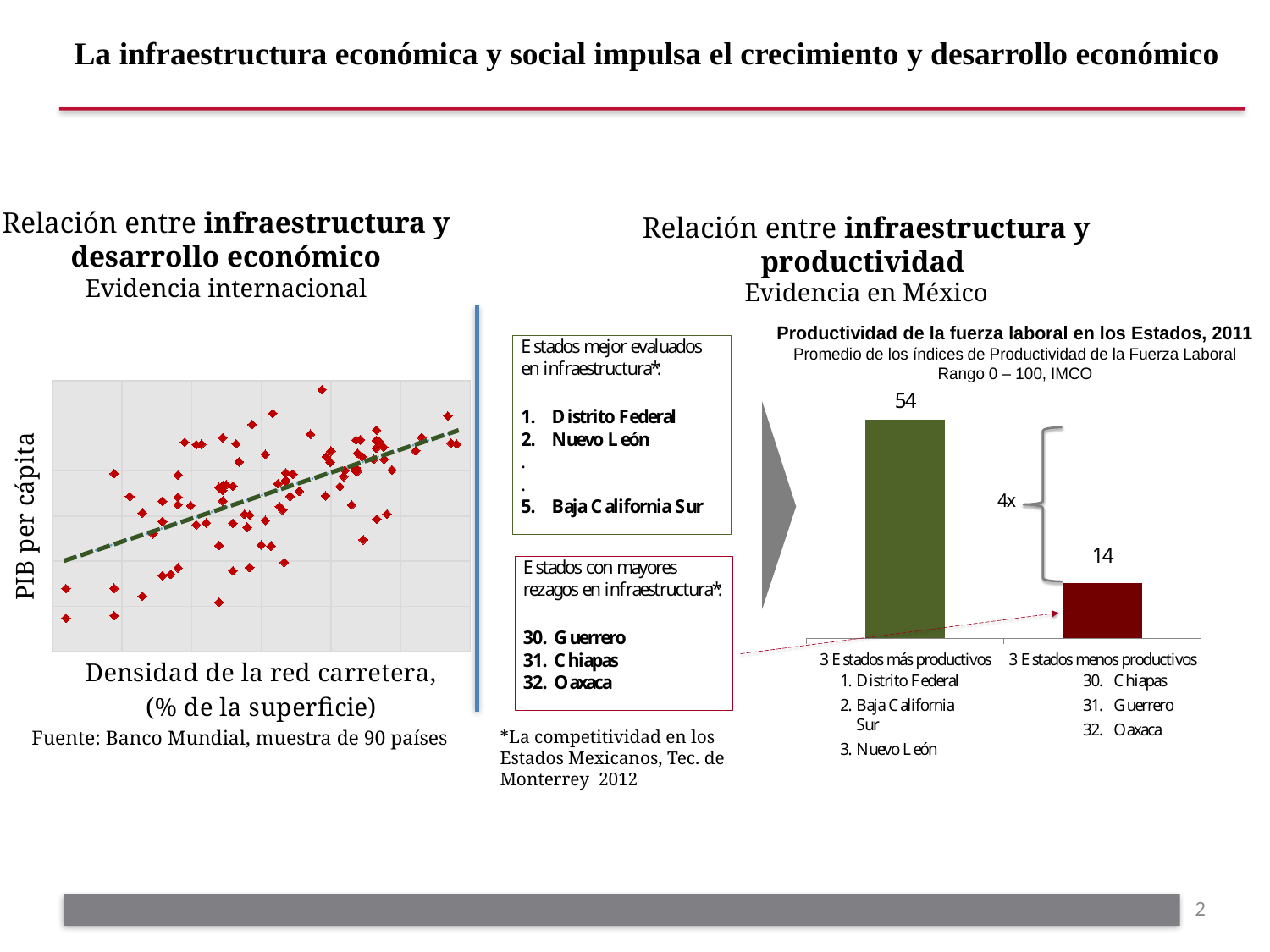
In the scatter plot on the left of the slide, do the values of PIB per cápita generally rise or fall as the density of the road network increases? Rise In the scatter plot on the left of the slide, what is the label of the y axis? PIB per cápita In the chart titled 'Productividad de la fuerza laboral en los Estados, 2011', what is the difference between the values for '3 Estados más productivos' and '3 Estados menos productivos'? 40 What kind of chart is the one on the left of the slide, under 'Evidencia internacional'? Scatter plot In the chart titled 'Productividad de la fuerza laboral en los Estados, 2011', which is larger: the value for '3 Estados más productivos' or '3 Estados menos productivos'? 3 Estados más productivos In the chart titled 'Productividad de la fuerza laboral en los Estados, 2011', what is the value for '3 Estados más productivos'? 54 What kind of chart is the one titled 'Productividad de la fuerza laboral en los Estados, 2011'? Bar chart In the chart titled 'Productividad de la fuerza laboral en los Estados, 2011', which category has the highest value? 3 Estados más productivos In the chart titled 'Productividad de la fuerza laboral en los Estados, 2011', how many bars are plotted? 2 In the chart titled 'Productividad de la fuerza laboral en los Estados, 2011', which category has the lowest value? 3 Estados menos productivos In the chart titled 'Productividad de la fuerza laboral en los Estados, 2011', what multiplier is shown between the two bars? 4x In the chart titled 'Productividad de la fuerza laboral en los Estados, 2011', what is the value for '3 Estados menos productivos'? 14